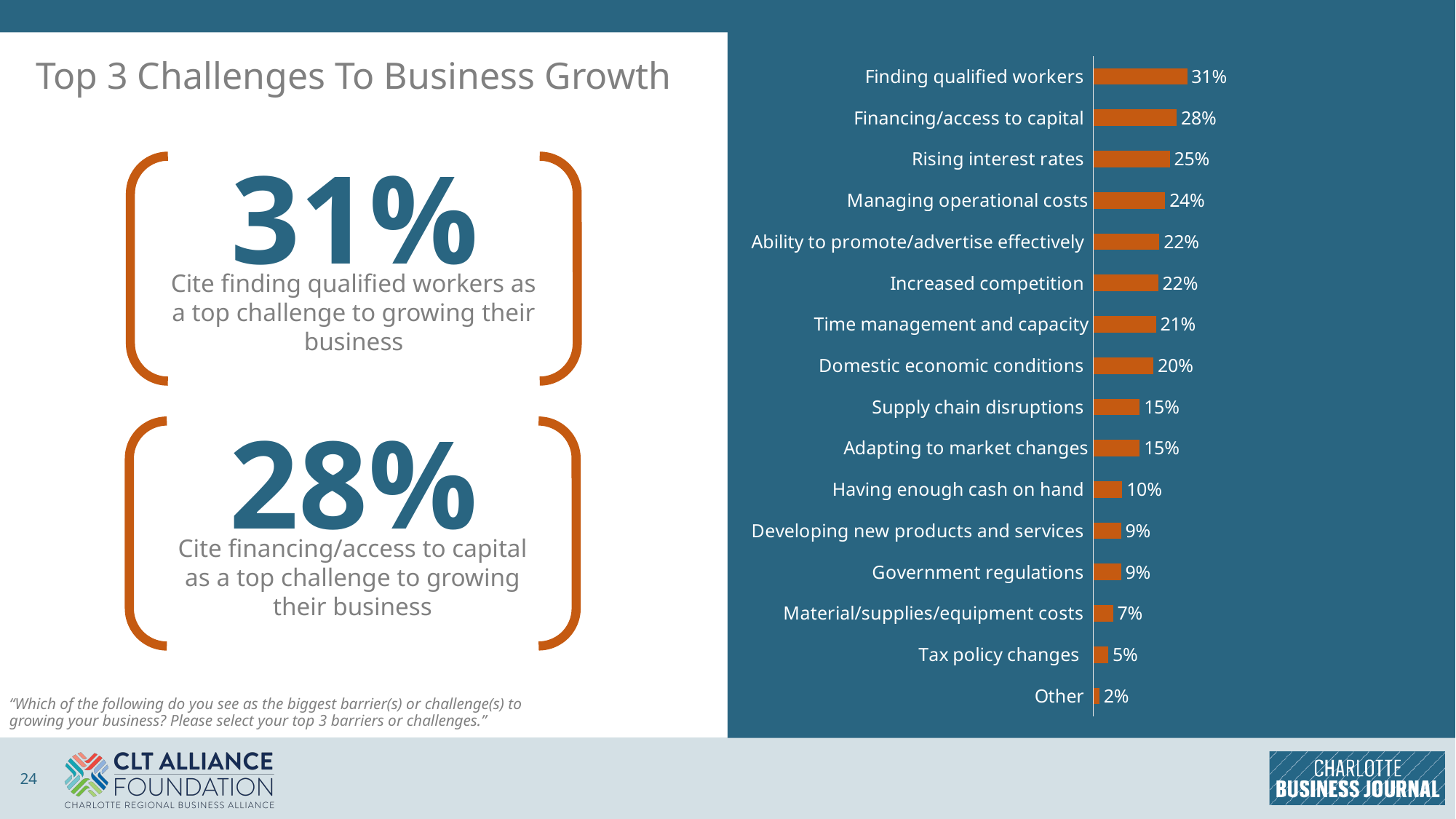
What kind of chart is shown on the slide? Bar chart Which category has the highest value? Finding qualified workers What is the title of the slide containing the chart? Top 3 Challenges To Business Growth What is the value for Rising interest rates? 25% What is the value for Tax policy changes? 5% What is the difference between Managing operational costs and Material/supplies/equipment costs? 17% What is the value for Having enough cash on hand? 10% What is the value for Finding qualified workers? 31% What is the difference between Finding qualified workers and Financing/access to capital? 3% How many categories are shown in the chart? 16 Which is larger, Supply chain disruptions or Domestic economic conditions? Domestic economic conditions Which category has the lowest value? Other